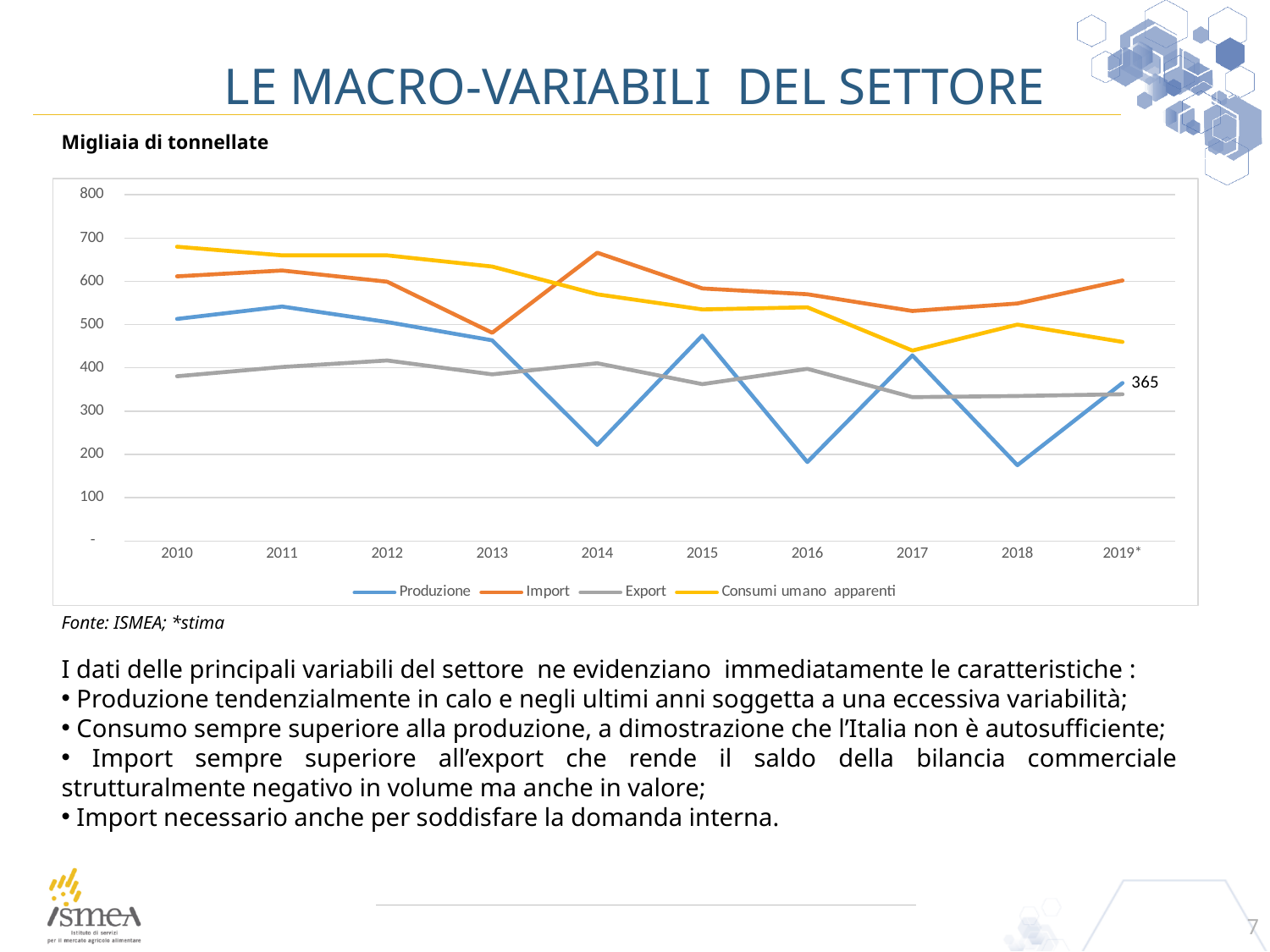
In which year does the Import series reach its highest value? 2014 What kind of chart is shown on the slide? line chart In 2016, which is larger, Produzione or Export? Export Is the value for Consumi umano apparenti in 2010 greater or less than 600? greater How many series does the legend list? 4 What is the value of Produzione in 2019*? 365 In 2010, which is larger, Import or Export? Import Does the Consumi umano apparenti series rise or fall from 2010 to 2019*? fall Is the value for Produzione in 2014 greater or less than 300? less Which series has the highest value in 2010? Consumi umano apparenti Is the value for Import in 2014 greater or less than 600? greater How many years are shown on the x axis? 10